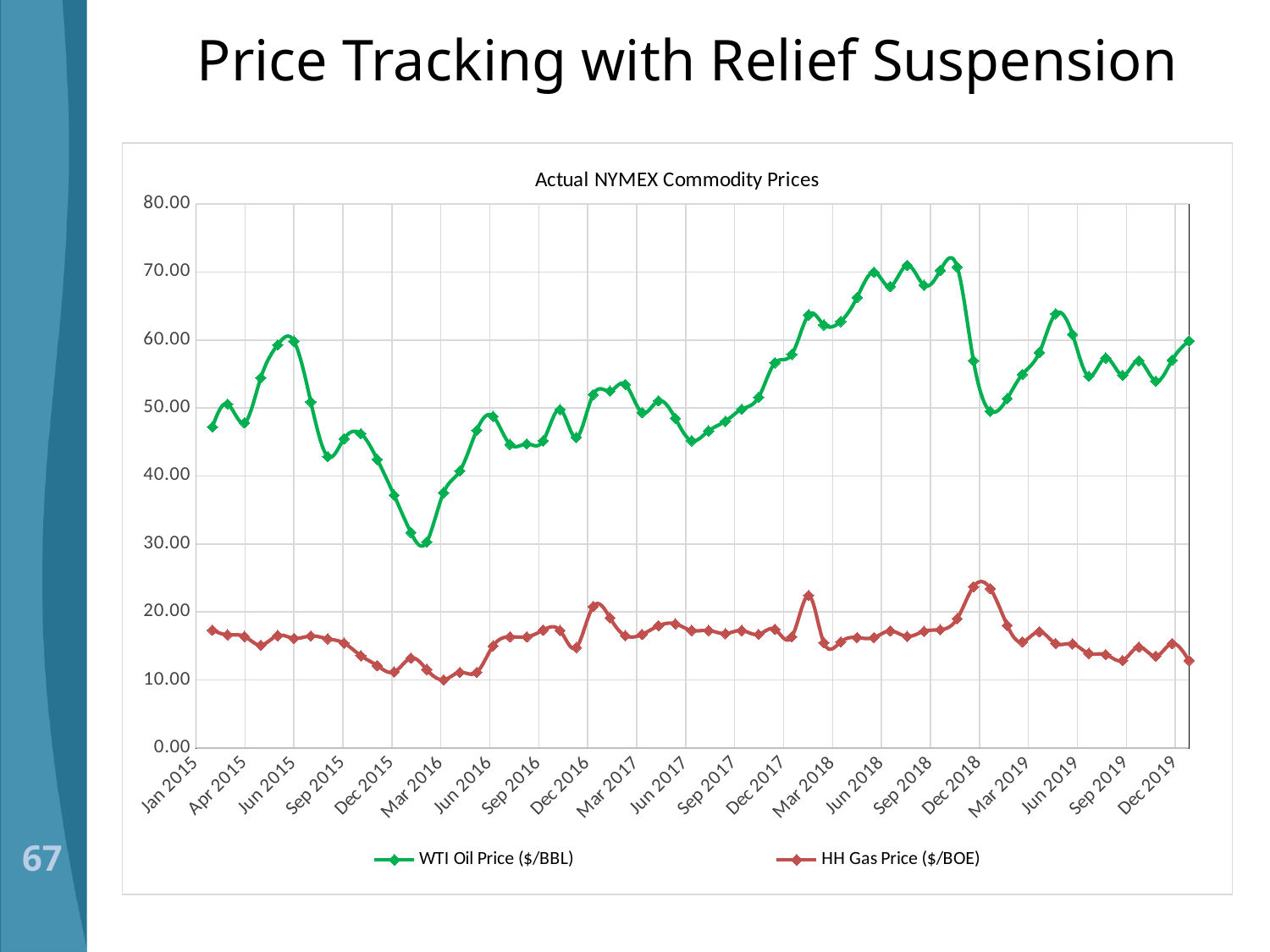
How many series does the legend list? 2 Which series is drawn in green? WTI Oil Price ($/BBL) Is the WTI Oil Price higher at Jan 2015 or at Mar 2016? Jan 2015 Is the WTI Oil Price at Jan 2015 greater or less than 50.00? less Which series has the higher values throughout the chart, WTI Oil Price or HH Gas Price? WTI Oil Price ($/BBL) Is the HH Gas Price at Mar 2018 greater or less than 20.00? less Is the HH Gas Price at Jan 2015 greater or less than 20.00? less What is the title of the chart? Actual NYMEX Commodity Prices What kind of chart is shown on the slide? Line chart Does the HH Gas Price generally rise or fall from Dec 2018 to Dec 2019? fall